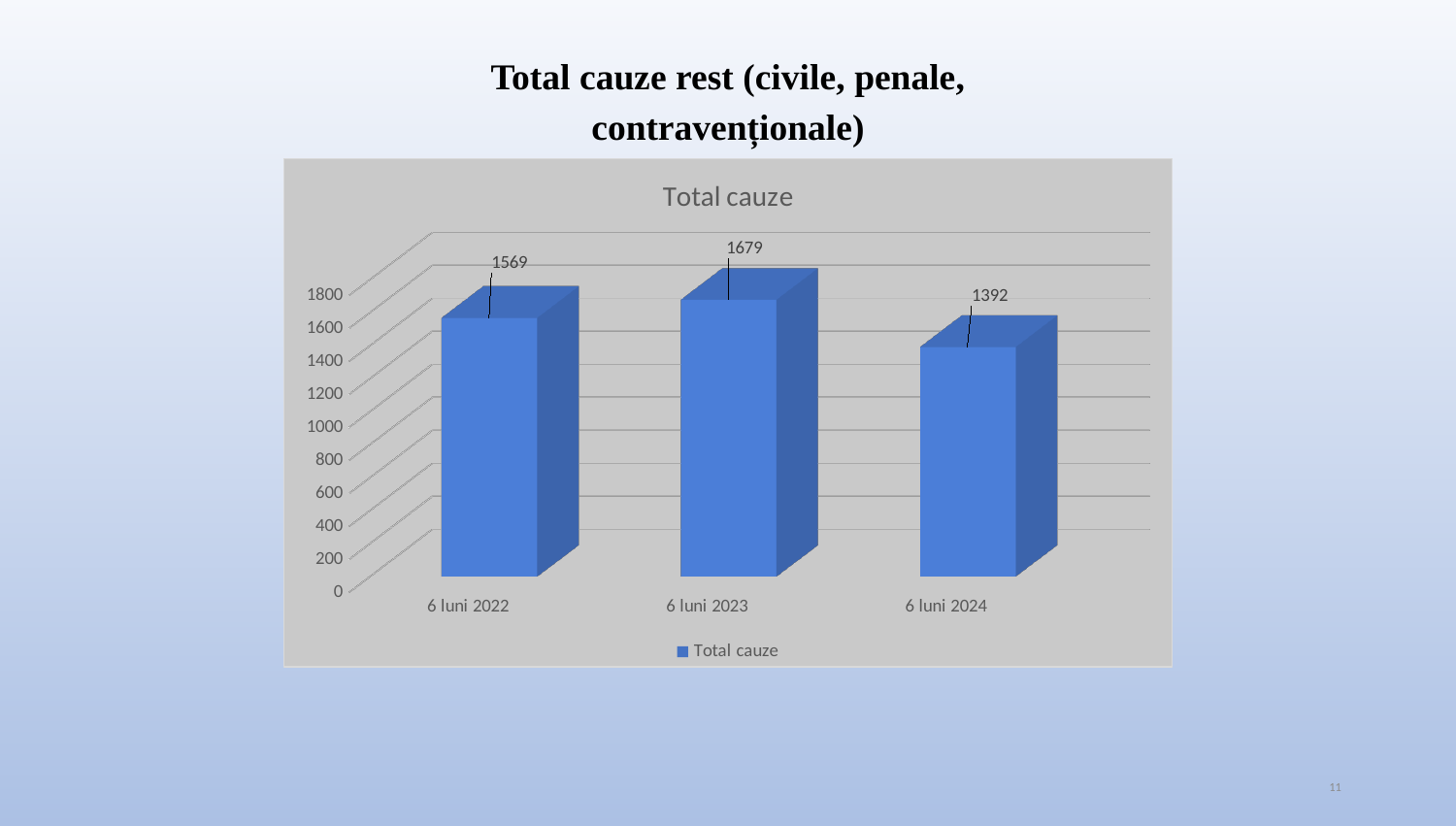
Which category has the lowest value? 6 luni 2024 What is the difference between the values for 6 luni 2023 and 6 luni 2022? 110 What is the value for 6 luni 2023? 1679 What is the difference between the values for 6 luni 2023 and 6 luni 2024? 287 What is the value for 6 luni 2024? 1392 How many categories are shown on the x axis? 3 What kind of chart is shown? bar chart How many series does the legend list? 1 What is the value for 6 luni 2022? 1569 Which is larger, the value for 6 luni 2022 or the value for 6 luni 2024? 6 luni 2022 What is the title of the chart? Total cauze Which category has the highest value? 6 luni 2023